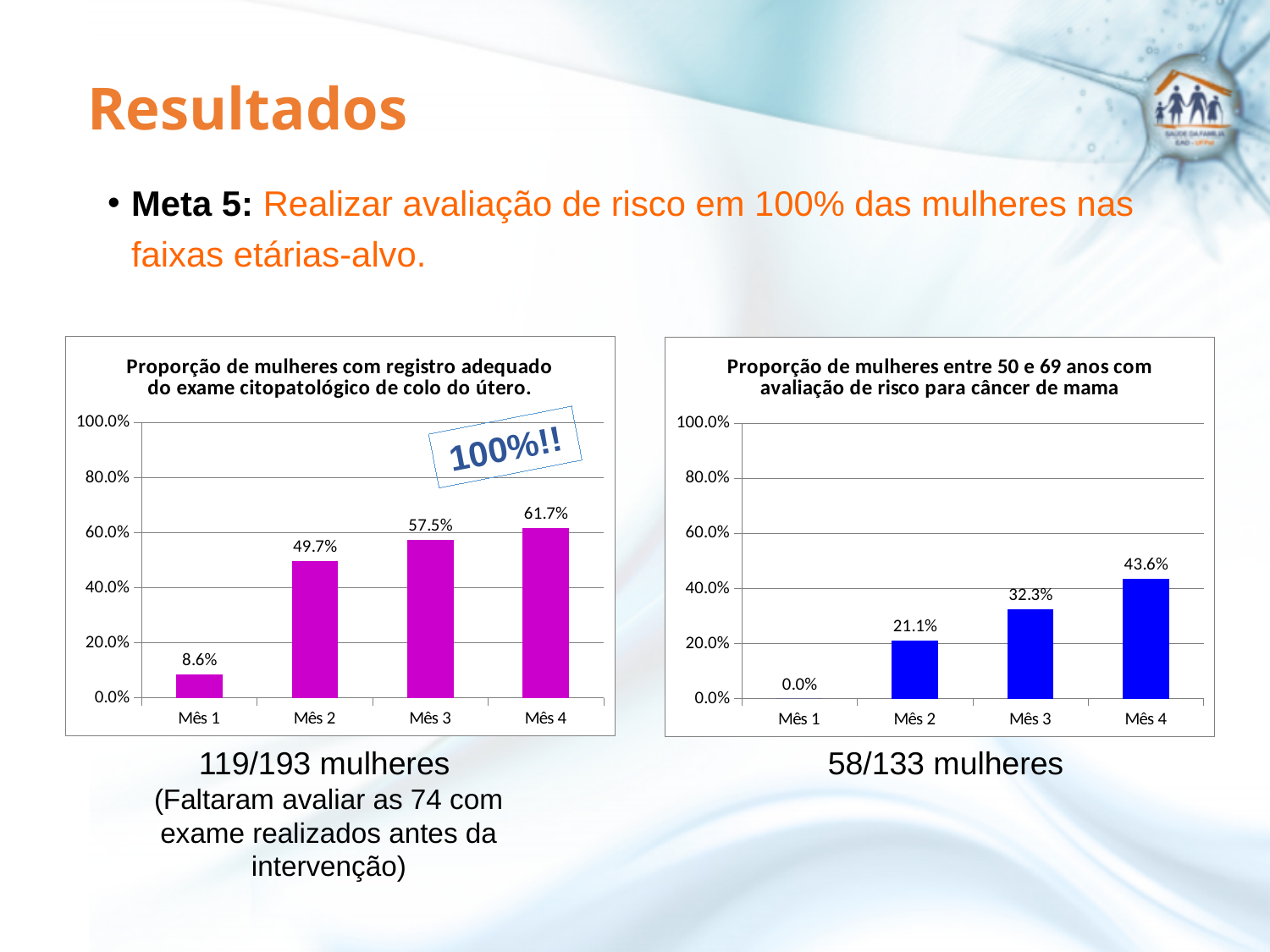
What type of chart is the right chart (avaliação de risco para câncer de mama)? bar chart In the right chart (avaliação de risco para câncer de mama), what is the value for Mês 3? 32.3% How many months are shown on the x axis of the left chart (registro adequado do exame citopatológico)? 4 In the left chart (registro adequado do exame citopatológico), which month has the lowest value? Mês 1 In the right chart (avaliação de risco para câncer de mama), do the values rise or fall from Mês 1 to Mês 4? rise In the left chart (registro adequado do exame citopatológico), what is the value for Mês 4? 61.7% In the left chart (registro adequado do exame citopatológico), what is the value for Mês 2? 49.7% In the left chart (registro adequado do exame citopatológico), what is the difference between Mês 2 and Mês 1? 41.1% In the right chart (avaliação de risco para câncer de mama), which month has the highest value? Mês 4 In the right chart (avaliação de risco para câncer de mama), what is the difference between Mês 4 and Mês 3? 11.3% Which is larger: Mês 4 in the left chart or Mês 4 in the right chart? Mês 4 in the left chart In the right chart (avaliação de risco para câncer de mama), what is the value for Mês 1? 0.0%